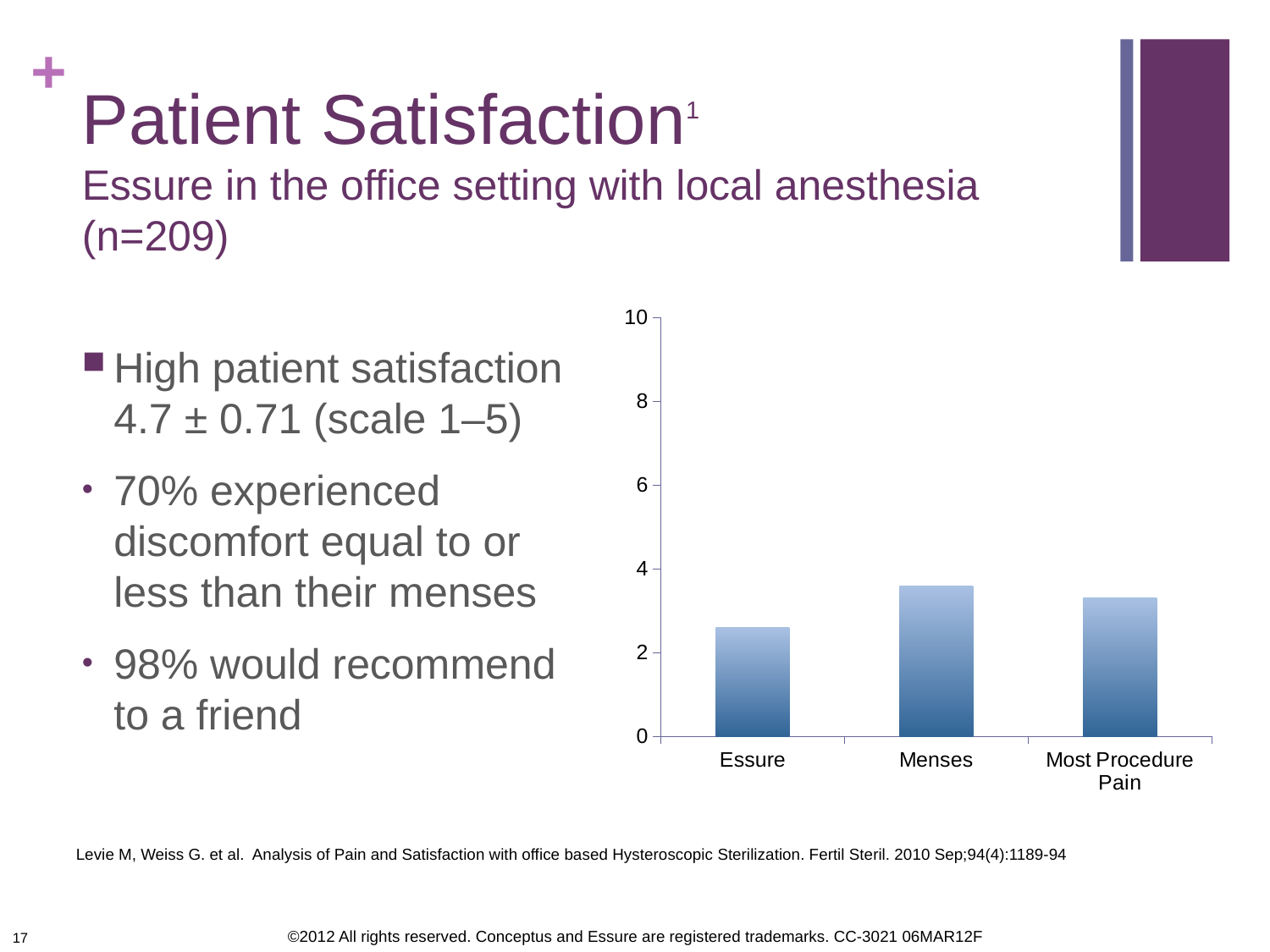
What kind of chart is shown on the slide? bar chart How many categories are plotted on the chart? 3 Which is larger, the value for Essure or the value for Menses? Menses Which category has the lowest bar on the chart? Essure Is the value for Essure greater or less than 4? less What are the three category labels on the chart's horizontal axis? Essure, Menses, Most Procedure Pain Is the value for Essure greater or less than 2? greater Which category has the highest bar on the chart? Menses Is the value for Most Procedure Pain greater or less than 2? greater Which is larger, the value for Essure or the value for Most Procedure Pain? Most Procedure Pain What is the maximum value shown on the chart's vertical axis? 10